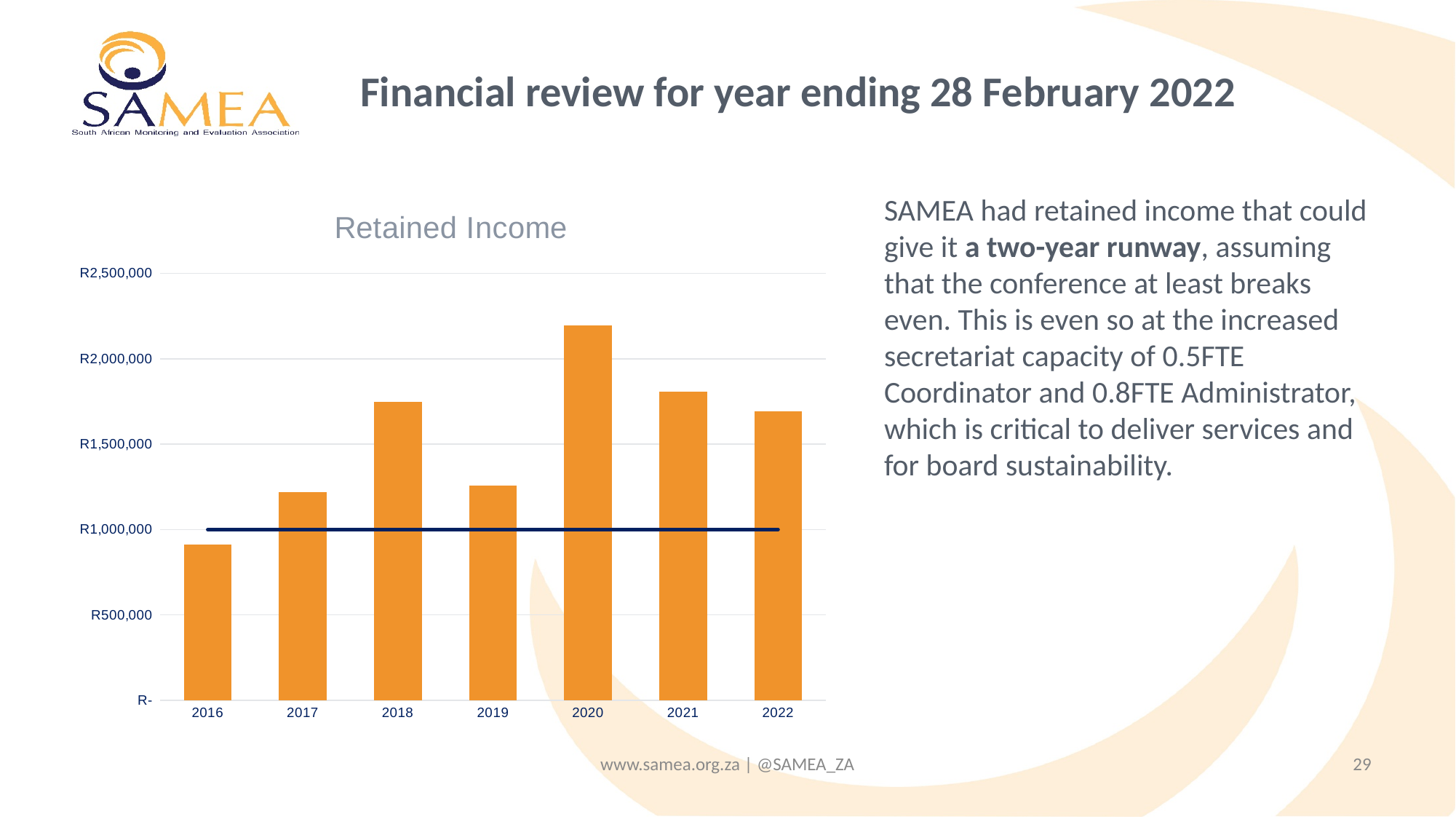
Is the retained income for 2019 greater or less than R1,500,000? less Which year has the lowest retained income? 2016 What kind of chart is shown on the slide? Combination bar and line chart Which year has the highest retained income? 2020 Which year has the larger retained income, 2020 or 2021? 2020 Is the retained income for 2020 greater or less than R2,000,000? greater Is the retained income for 2016 greater or less than R1,000,000? less What is the title of the chart? Retained Income Does retained income rise or fall from 2016 to 2018? rise Which year has the larger retained income, 2018 or 2019? 2018 How many years are shown on the x axis of the Retained Income chart? 7